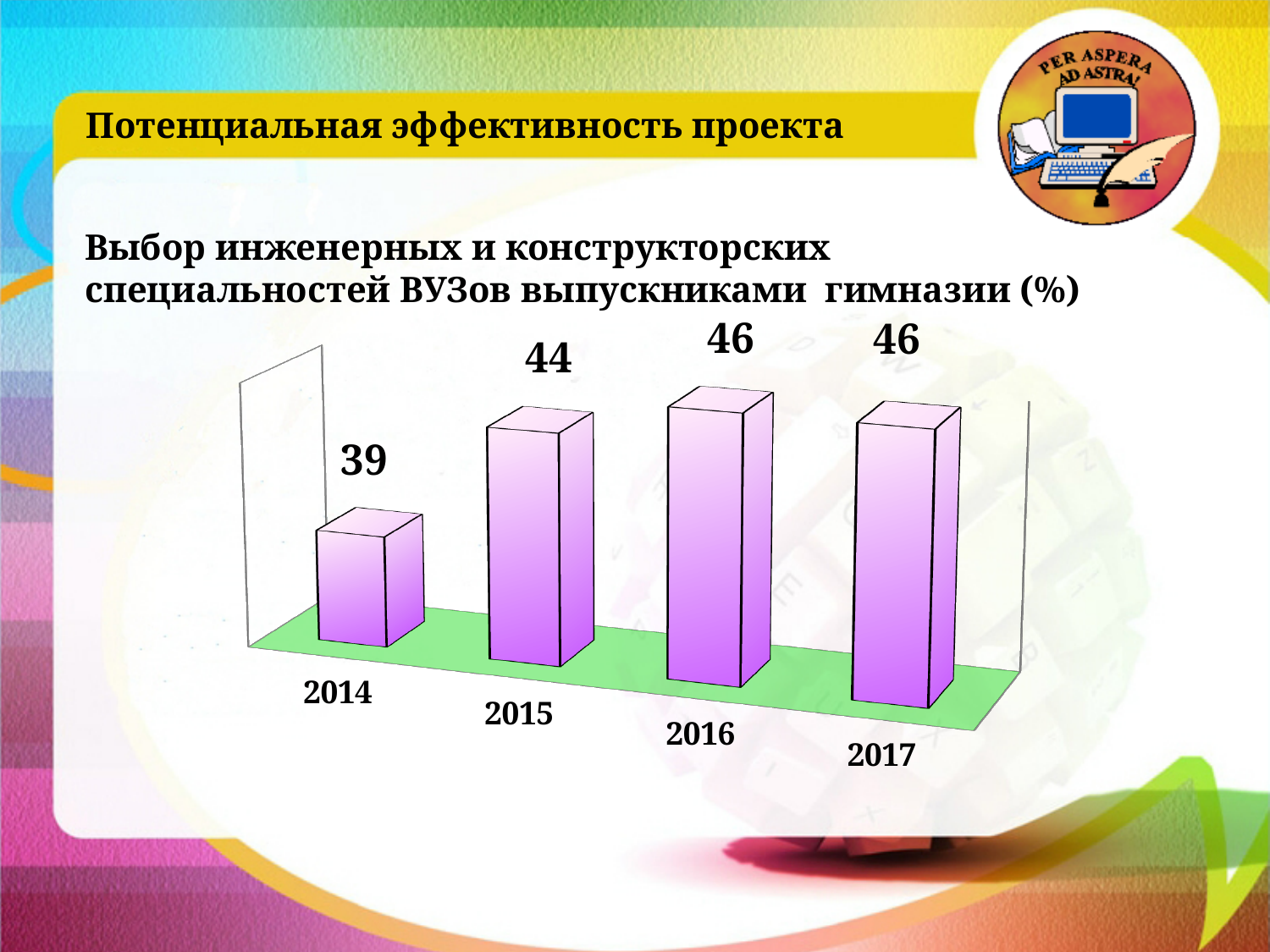
What is the value for 2016? 46 What is the title of the chart? Выбор инженерных и конструкторских специальностей ВУЗов выпускниками гимназии (%) What is the value for 2017? 46 What is the value for 2015? 44 What kind of chart is shown on the slide? bar chart Do the values rise or fall from 2014 to 2016? rise Which is larger, the value for 2015 or the value for 2016? 2016 How many years are shown in the chart? 4 Which year has the lowest value? 2014 What is the value for 2014? 39 What is the difference between the values for 2015 and 2014? 5 What is the difference between the values for 2016 and 2014? 7